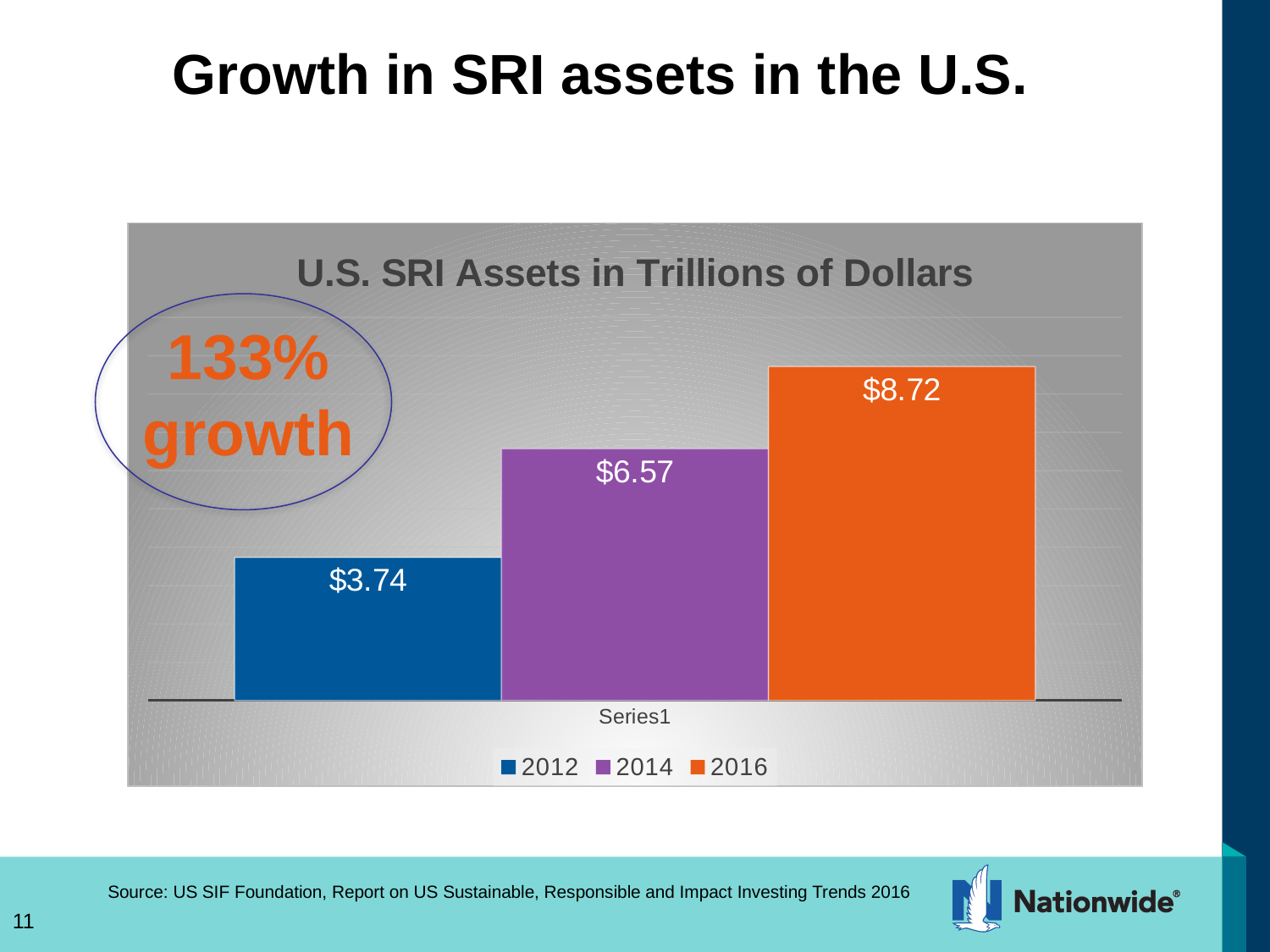
What is the value for 2014 in the U.S. SRI Assets in Trillions of Dollars chart? $6.57 Which year has the lowest value in the chart? 2012 What is the title of the chart? U.S. SRI Assets in Trillions of Dollars Which is larger, the value for 2014 or the value for 2016? 2016 How many series does the legend list? 3 What is the difference between the 2016 and 2012 values? $4.98 What is the difference between the 2014 and 2012 values? $2.83 What is the value for 2016 in the U.S. SRI Assets in Trillions of Dollars chart? $8.72 Which year has the highest value in the chart? 2016 What is the value for 2012 in the U.S. SRI Assets in Trillions of Dollars chart? $3.74 Do the values rise or fall from 2012 to 2016? Rise What kind of chart is shown on the slide? Bar chart